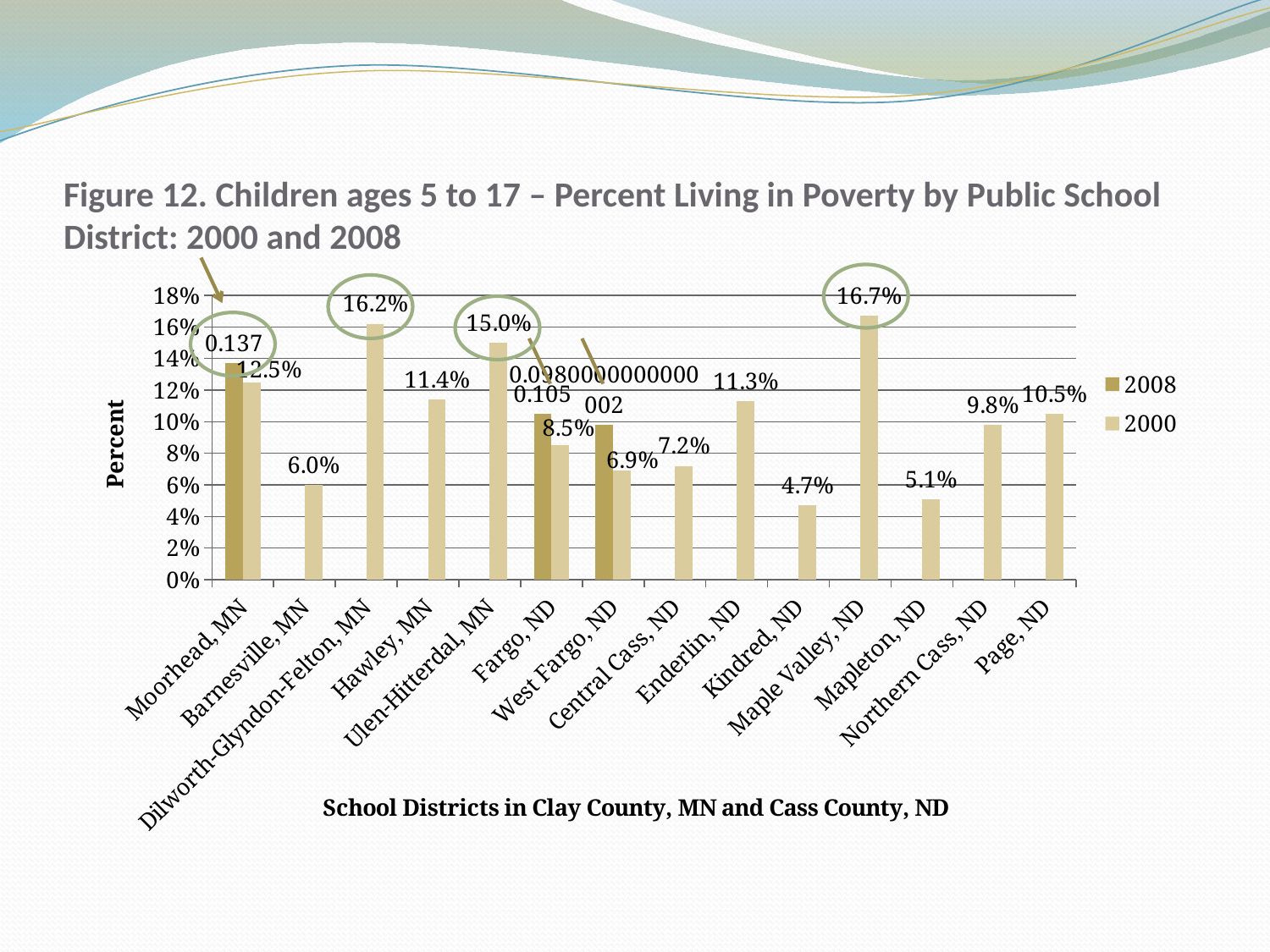
Is the 2000 value for Barnesville, MN greater or less than 8%? less What is the 2000 value for Hawley, MN? 11.4% How many series does the legend list? 2 Which school district has the highest value for 2000? Maple Valley, ND How many school districts are shown on the x axis? 14 What kind of chart is shown on the slide? bar chart Which has the larger 2000 value, Fargo, ND or West Fargo, ND? Fargo, ND What is the 2008 value shown for Moorhead, MN? 0.137 What is the 2008 value shown for Fargo, ND? 0.105 What is the difference between the 2000 values for Maple Valley, ND and Dilworth-Glyndon-Felton, MN? 0.5% What is the difference between the 2000 values for Moorhead, MN and Barnesville, MN? 6.5% Which school district has the lowest value for 2000? Kindred, ND